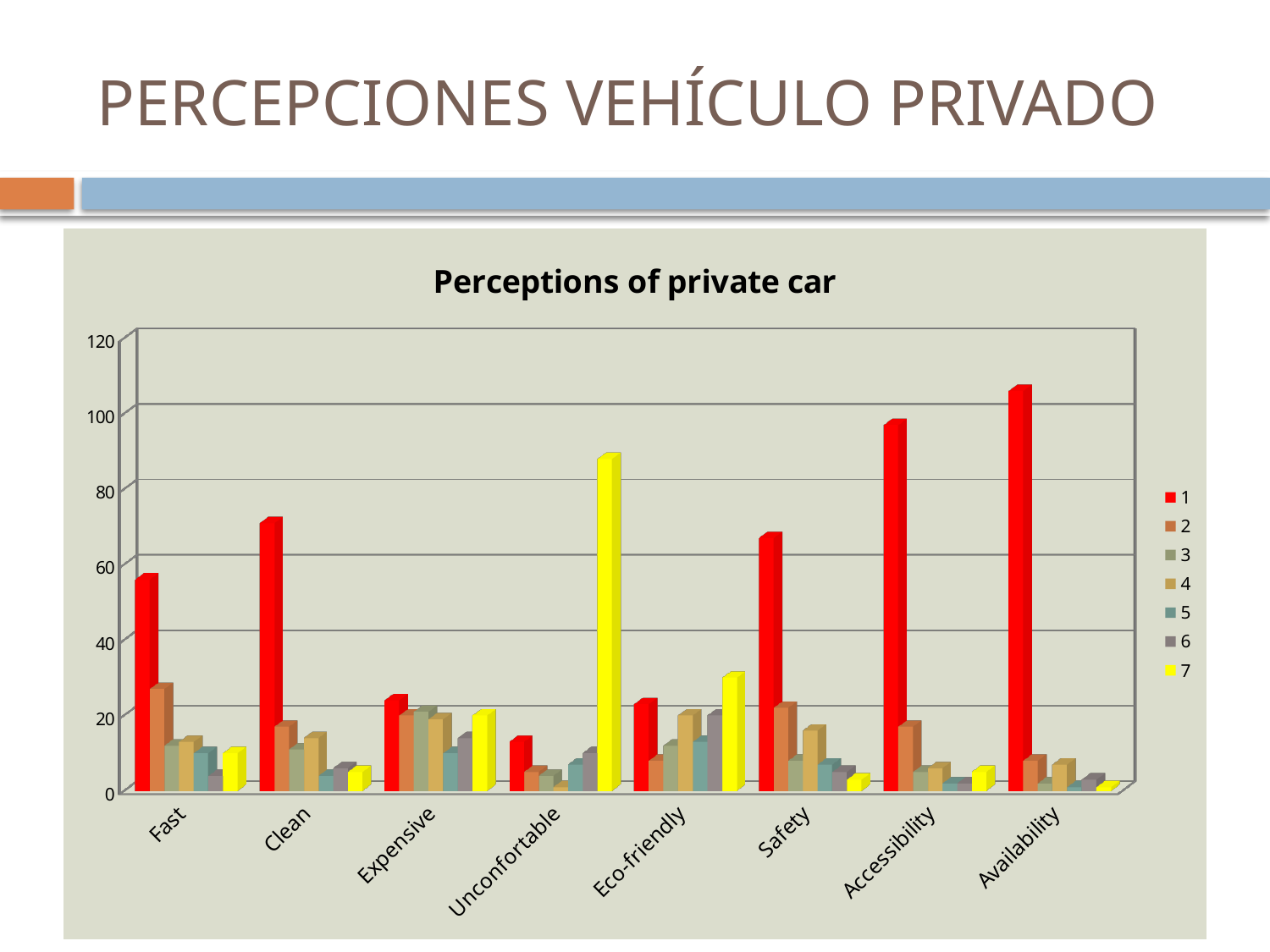
Which has the larger value for series 1: Availability or Accessibility? Availability For the Unconfortable category, which series has the tallest bar? 7 Is the value of series 1 for Clean greater or less than 60? greater How many series does the legend list? 7 Is the value of series 7 for Unconfortable greater or less than 80? greater How many categories are shown on the x axis of the chart? 8 Which has the larger value for series 1: Clean or Fast? Clean What is the title of the chart? Perceptions of private car What type of chart is shown on the slide? bar chart Is the value of series 1 for Availability greater or less than 100? greater For which category is the bar for series 1 the highest? Availability